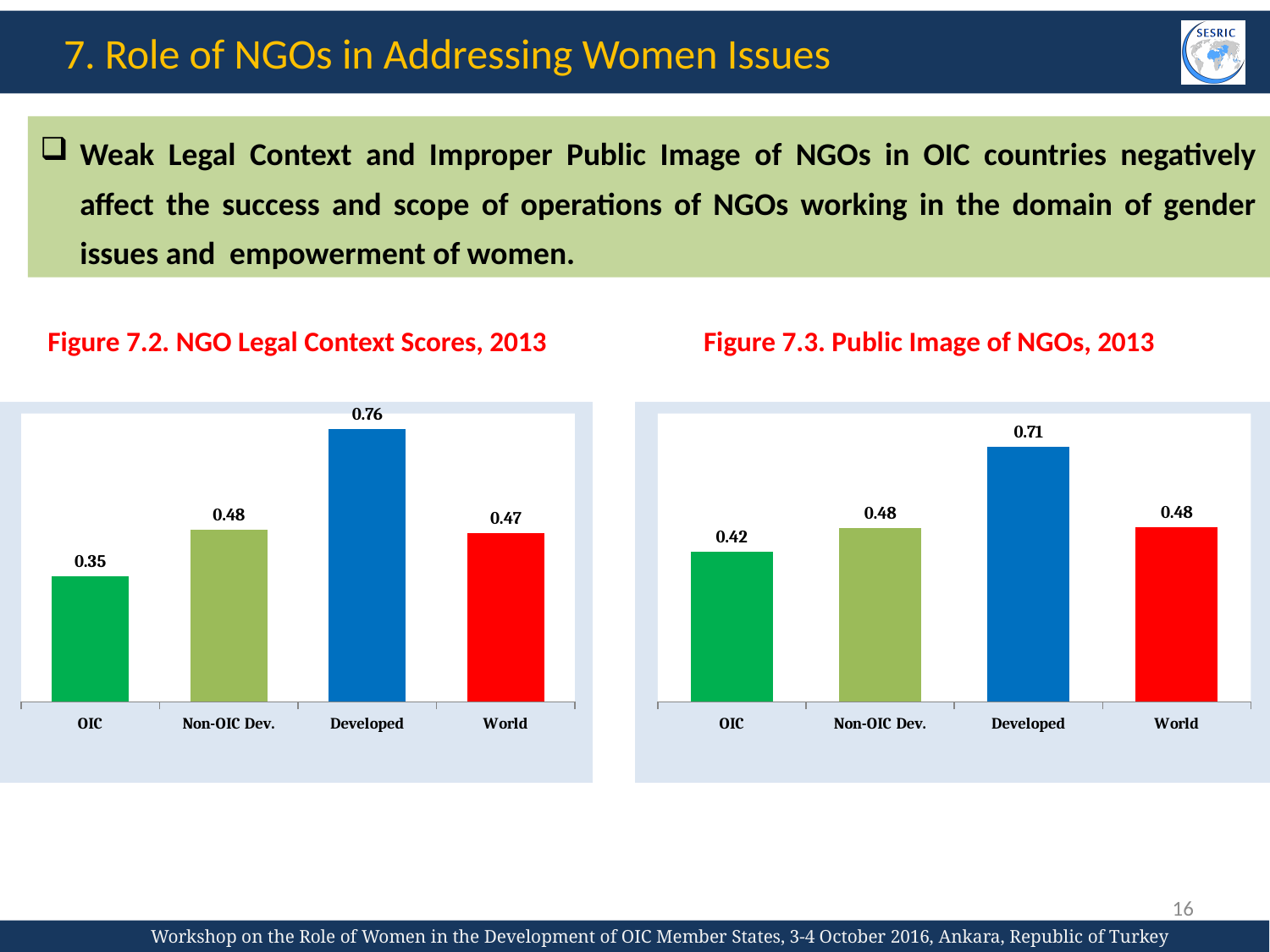
What colour is the Developed bar in Figure 7.3 (Public Image of NGOs, 2013)? Blue In Figure 7.2 (NGO Legal Context Scores, 2013), which category has the lowest value? OIC In Figure 7.2 (NGO Legal Context Scores, 2013), what is the difference between the Developed and OIC values? 0.41 What kind of chart is Figure 7.2 (NGO Legal Context Scores, 2013)? Bar chart In Figure 7.2 (NGO Legal Context Scores, 2013), which category has the highest value? Developed In Figure 7.2 (NGO Legal Context Scores, 2013), which is larger, Non-OIC Dev. or World? Non-OIC Dev. In Figure 7.3 (Public Image of NGOs, 2013), what is the value for OIC? 0.42 In Figure 7.3 (Public Image of NGOs, 2013), which category has the lowest value? OIC In Figure 7.3 (Public Image of NGOs, 2013), what is the difference between the Developed and World values? 0.23 How many categories are shown in Figure 7.3 (Public Image of NGOs, 2013)? 4 In Figure 7.3 (Public Image of NGOs, 2013), what is the value for Developed? 0.71 In Figure 7.2 (NGO Legal Context Scores, 2013), what is the value for OIC? 0.35